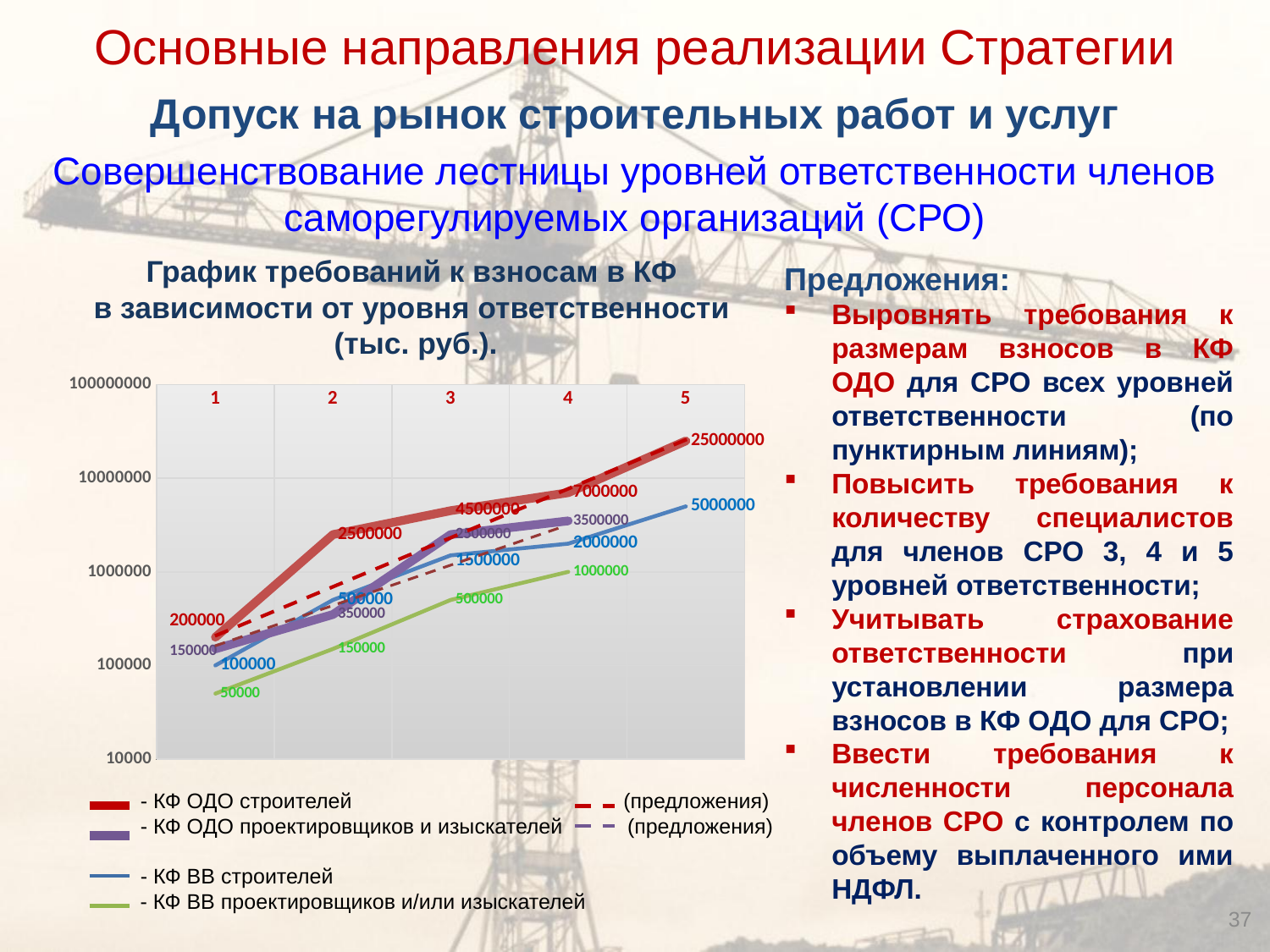
What is the value for КФ ВВ проектировщиков и/или изыскателей at level 1? 50000 What is the value for КФ ОДО строителей at level 5? 25000000 What is the value for КФ ОДО строителей at level 1? 200000 At which level is the value for КФ ОДО строителей highest? 5 What is the value for КФ ОДО проектировщиков и изыскателей at level 4? 3500000 At which level is the value for КФ ВВ строителей lowest? 1 How many responsibility levels are shown on the x axis? 5 What kind of chart is shown on the slide? line chart Which is larger at level 3: КФ ОДО строителей or КФ ВВ строителей? КФ ОДО строителей Do the values for КФ ВВ строителей rise or fall from level 1 to level 5? rise What is the difference between the КФ ОДО строителей values at level 5 and level 4? 18000000 What is the value for КФ ВВ строителей at level 5? 5000000